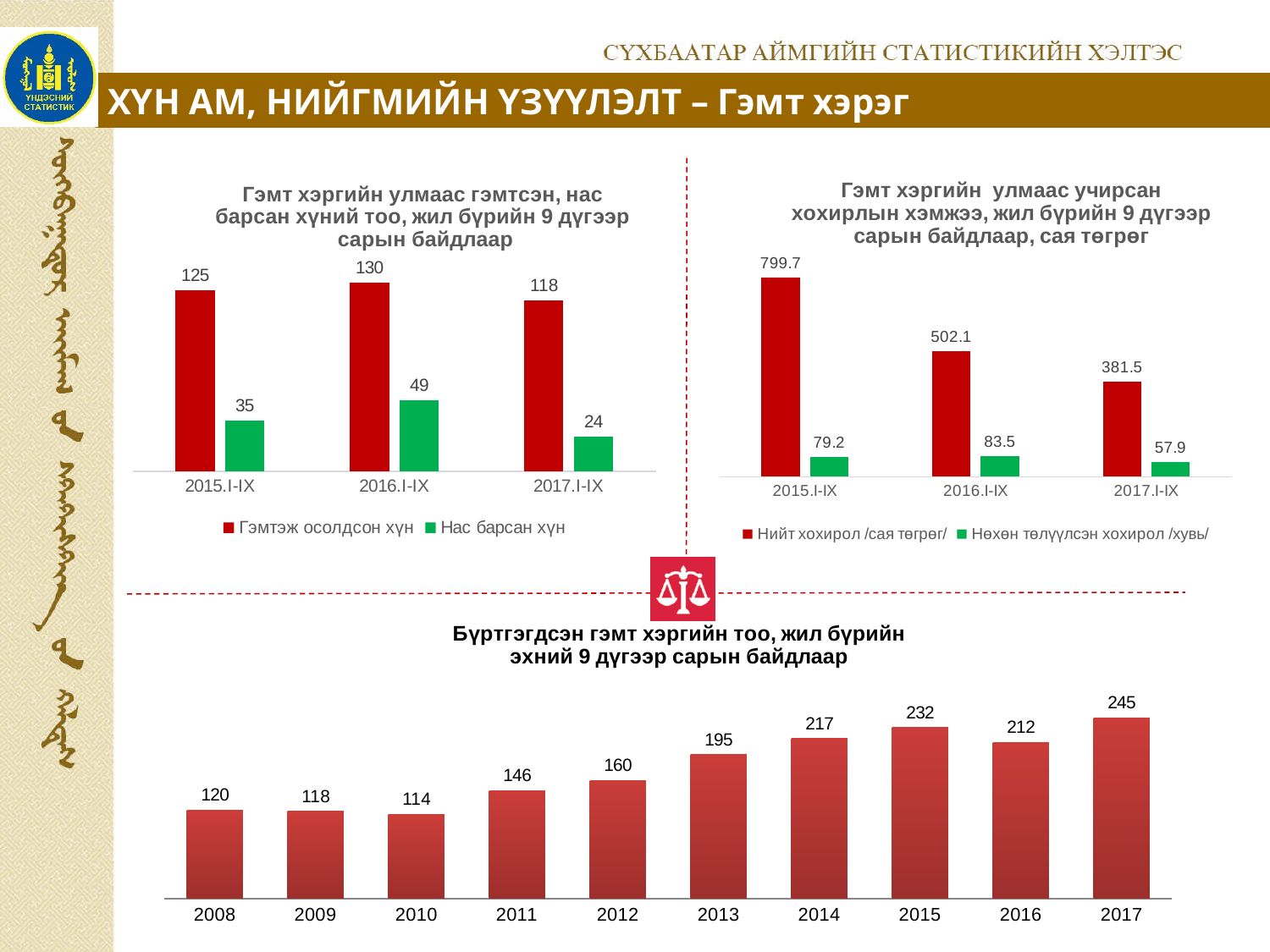
In the bottom chart (Бүртгэгдсэн гэмт хэргийн тоо), which year has the highest value? 2017 In the top-left chart (Гэмт хэргийн улмаас гэмтсэн, нас барсан хүний тоо), what is the value for Нас барсан хүн in 2016.I-IX? 49 In the top-right chart (Гэмт хэргийн улмаас учирсан хохирлын хэмжээ), what is the value for Нийт хохирол in 2015.I-IX? 799.7 In the top-right chart (Гэмт хэргийн улмаас учирсан хохирлын хэмжээ), which year has the lowest value for Нөхөн төлүүлсэн хохирол? 2017.I-IX In the bottom chart (Бүртгэгдсэн гэмт хэргийн тоо), what is the difference between the values for 2017 and 2016? 33 In the top-left chart (Гэмт хэргийн улмаас гэмтсэн, нас барсан хүний тоо), what is the value for Гэмтэж осолдсон хүн in 2017.I-IX? 118 In the bottom chart (Бүртгэгдсэн гэмт хэргийн тоо), which year has the lowest value? 2010 In the bottom chart (Бүртгэгдсэн гэмт хэргийн тоо), how many years are shown on the x axis? 10 In the top-left chart (Гэмт хэргийн улмаас гэмтсэн, нас барсан хүний тоо), how many series does the legend list? 2 In the top-right chart (Гэмт хэргийн улмаас учирсан хохирлын хэмжээ), does the Нийт хохирол value rise or fall from 2015.I-IX to 2017.I-IX? fall In the bottom chart (Бүртгэгдсэн гэмт хэргийн тоо), what is the value for 2014? 217 What kind of chart is the bottom chart (Бүртгэгдсэн гэмт хэргийн тоо)? bar chart